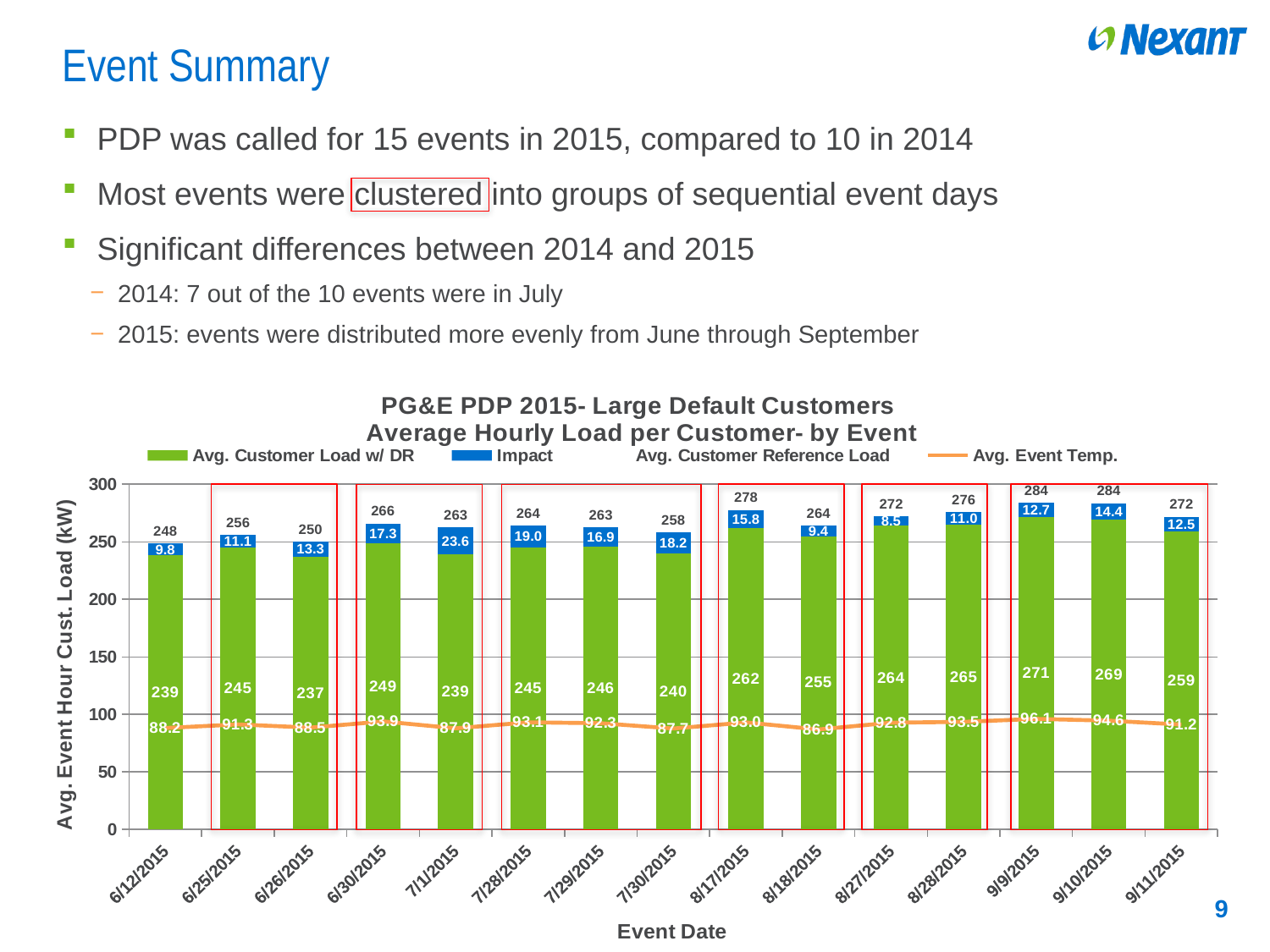
What is the Avg. Customer Reference Load for the 8/17/2015 event? 278 How many series does the legend list? 4 What is the Impact value for the 7/1/2015 event? 23.6 Which event has the higher Avg. Event Temp., 9/9/2015 or 8/18/2015? 9/9/2015 Which event date has the lowest Impact value? 8/27/2015 Which event date has the lowest Avg. Customer Load w/ DR? 6/26/2015 What is the Avg. Event Temp. for the 8/18/2015 event? 86.9 What is the difference between the Impact values for 7/1/2015 and 6/12/2015? 13.8 Which event date has the highest Avg. Event Temp.? 9/9/2015 What is the Avg. Customer Load w/ DR for the 9/9/2015 event? 271 Which event date has the highest Impact value? 7/1/2015 How many event dates are shown on the x axis? 15